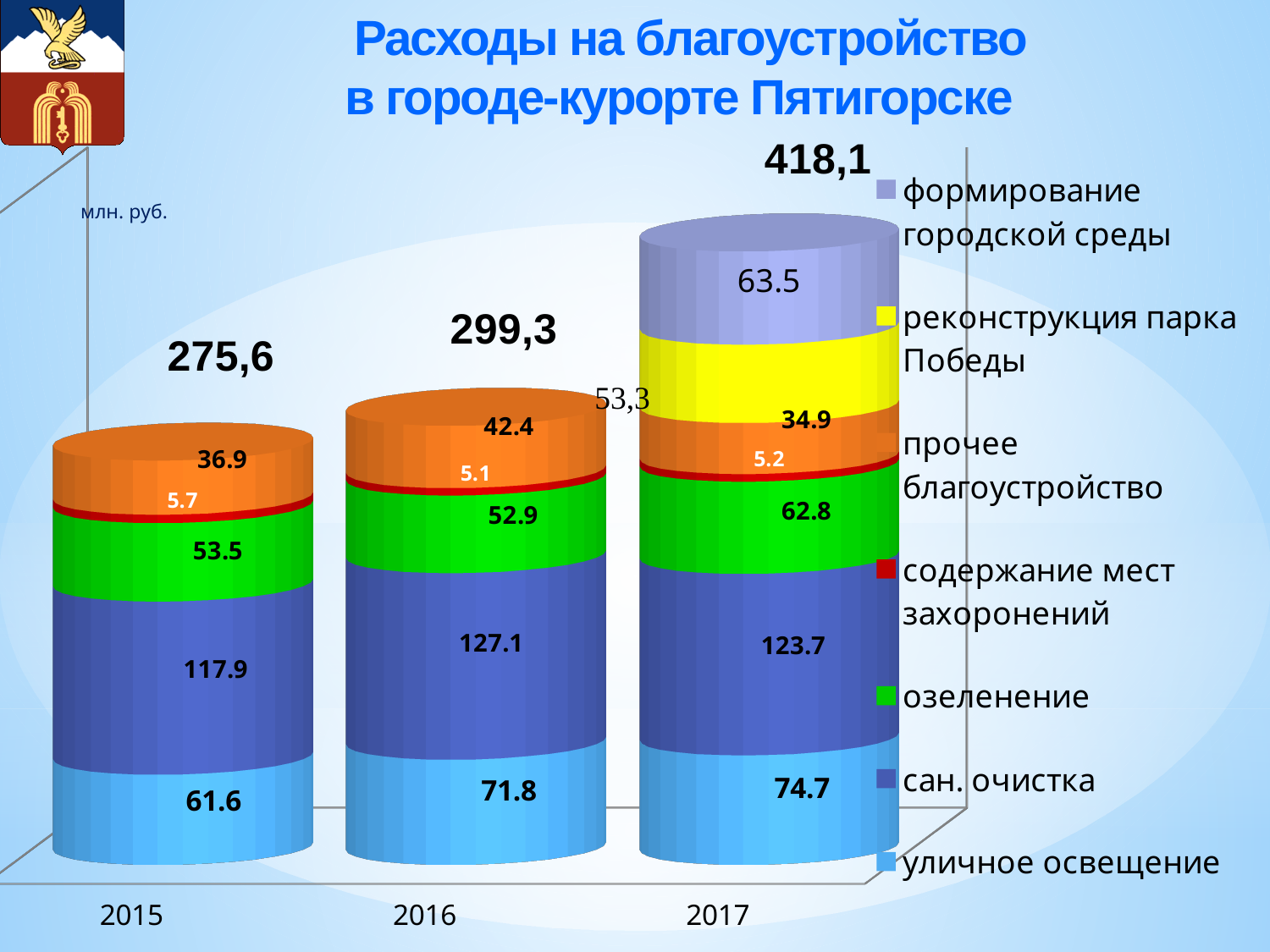
What is the value for формирование городской среды in 2017? 63.5 Which year has the highest total expenditure? 2017 What is the total of the stacked bar for 2017? 418,1 What is the value for уличное освещение in 2015? 61.6 What type of chart is shown on the slide? stacked bar chart How many series does the legend list? 7 How many years (categories) are shown on the x axis? 3 Which is larger: прочее благоустройство in 2016 or in 2017? 2016 What is the value for сан. очистка in 2016? 127.1 Which year has the lowest total expenditure? 2015 Do the total expenditures rise or fall from 2015 to 2017? rise What is the difference between the озеленение values for 2017 and 2016? 9.9